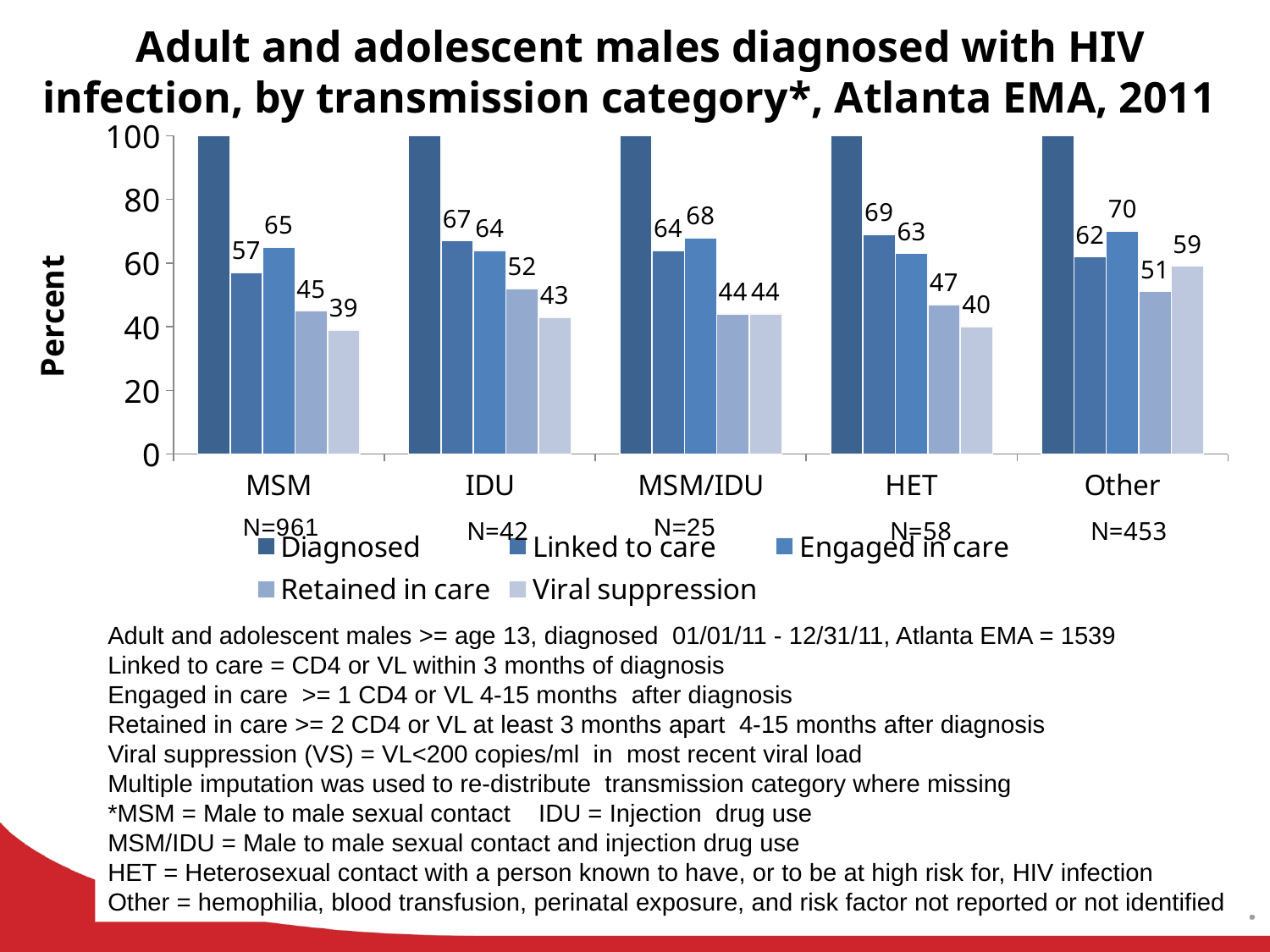
What is the Viral suppression value for MSM? 39 What is the Retained in care value for IDU? 52 How many series does the legend list? 5 How many transmission categories are shown on the x axis? 5 What is the Linked to care value for HET? 69 Is the Diagnosed value for IDU greater or less than 80? greater Which is larger for MSM/IDU: Linked to care or Engaged in care? Engaged in care Which transmission category has the lowest Linked to care value? MSM Which transmission category has the highest Viral suppression value? Other What is the difference between the Engaged in care and Retained in care values for Other? 19 What is the label on the y axis? Percent What type of chart is shown on the slide? bar chart